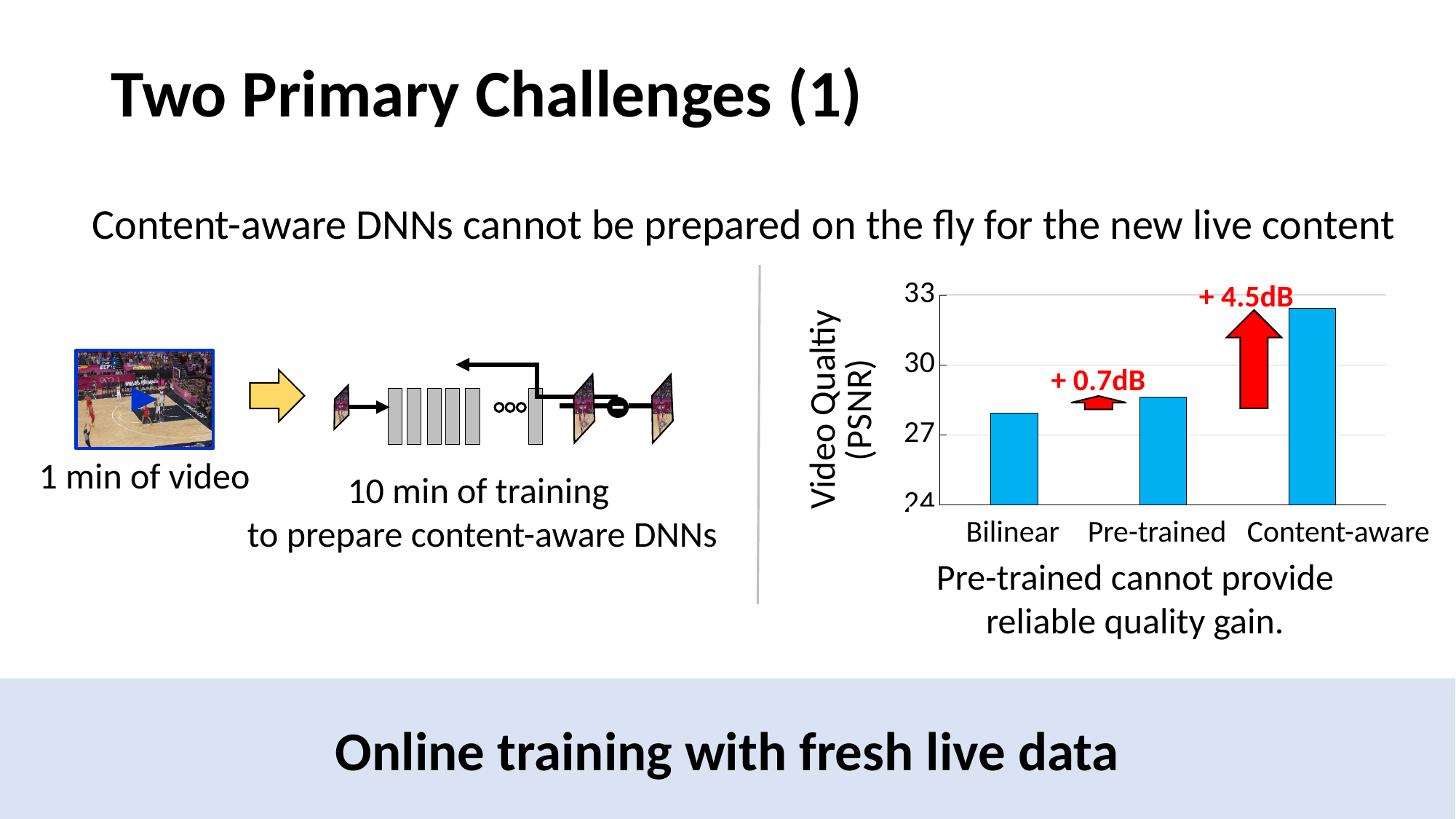
Is the value for Bilinear greater or less than 27? greater What gain is annotated above the Pre-trained bar? + 0.7dB Which category has the lowest video quality (PSNR) in the bar chart? Bilinear What gain is annotated above the Content-aware bar? + 4.5dB What kind of chart is shown on the right side of the slide? bar chart Do the bar values rise or fall from Bilinear to Content-aware along the x axis? rise Is the value for Content-aware greater or less than 30? greater Which category has the highest video quality (PSNR) in the bar chart? Content-aware What is the label of the y axis of the bar chart? Video Qualtiy (PSNR) How many categories are shown on the x axis of the bar chart? 3 Is the value for Pre-trained greater or less than 30? less Which has a higher PSNR value, Pre-trained or Bilinear? Pre-trained